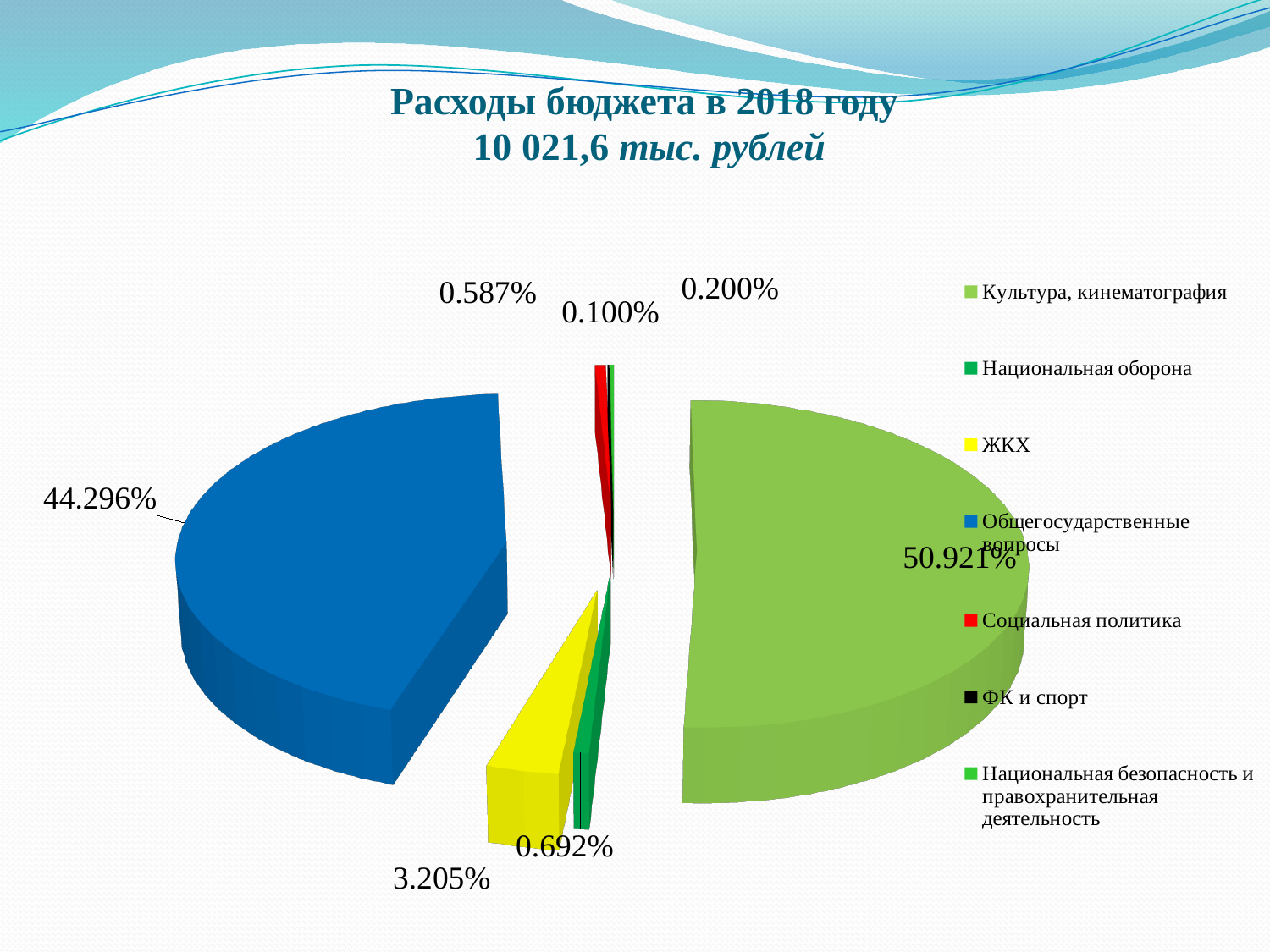
What percentage is shown for Национальная оборона? 0.692% Which is larger: the slice for Культура, кинематография or the slice for Общегосударственные вопросы? Культура, кинематография What kind of chart is shown on the slide? pie chart Which category has the largest slice of the pie? Культура, кинематография What colour is the ЖКХ slice? yellow What is the title of the chart? Расходы бюджета в 2018 году 10 021,6 тыс. рублей How many categories does the legend list? 7 What share of the 2018 budget expenditure goes to Культура, кинематография? 50.921% What share of the pie is Общегосударственные вопросы? 44.296% By how many percentage points does Культура, кинематография exceed Общегосударственные вопросы? 6.625% By how many percentage points does ЖКХ exceed Национальная оборона? 2.513% What percentage is shown for ЖКХ? 3.205%